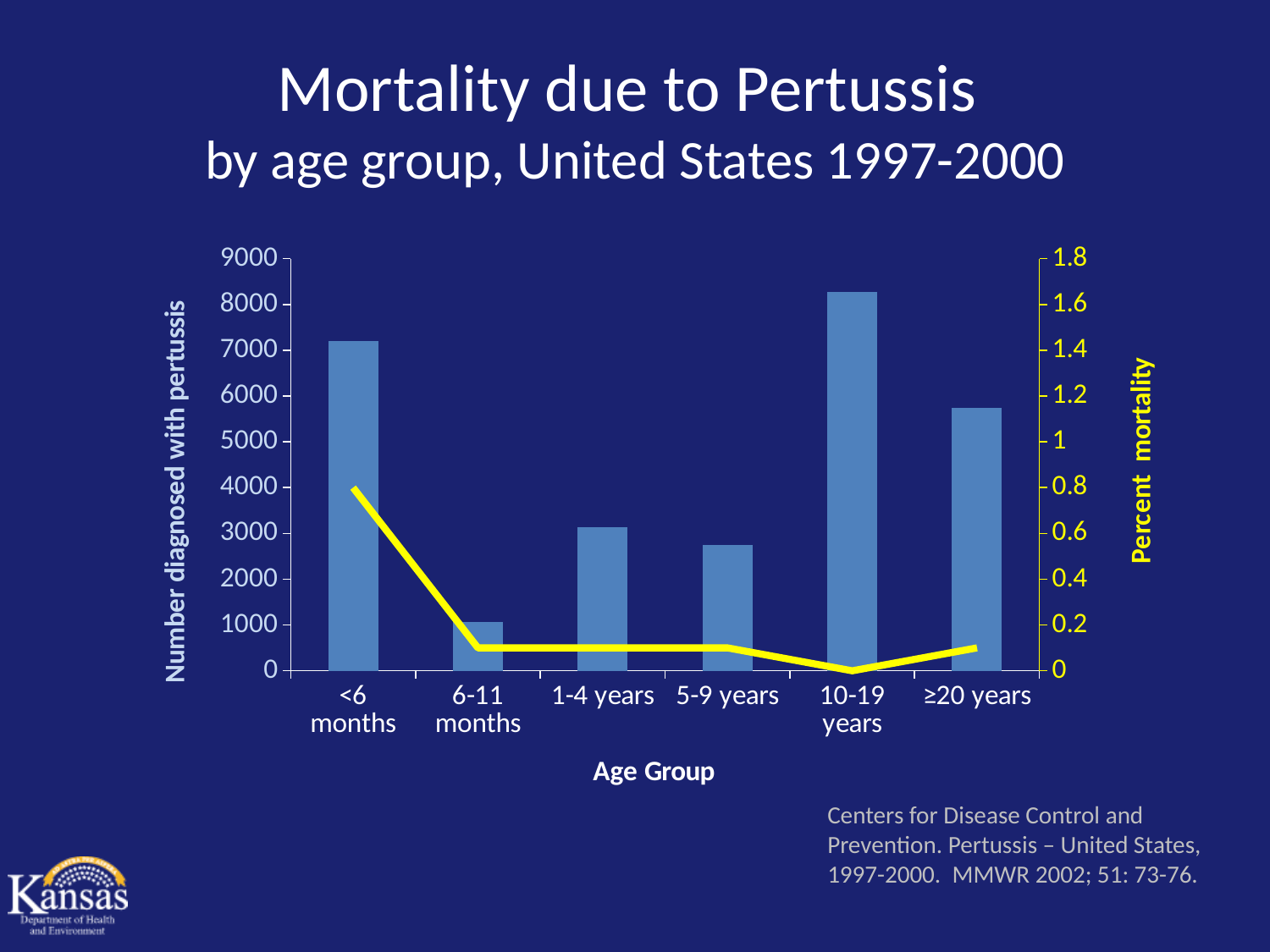
Is the number diagnosed with pertussis for 10-19 years greater or less than 8000? greater What is the title of the right-hand vertical axis? Percent mortality What kind of chart is shown on the slide? A bar chart combined with a line chart Is the number diagnosed with pertussis for ≥20 years greater or less than 5000? greater Which age group has the lowest number diagnosed with pertussis? 6-11 months Is the percent mortality for <6 months greater or less than 0.6? greater Which age group has the highest percent mortality? <6 months Which age group has the highest number diagnosed with pertussis? 10-19 years How many age groups are shown on the x axis? 6 Which has more people diagnosed with pertussis, <6 months or ≥20 years? <6 months